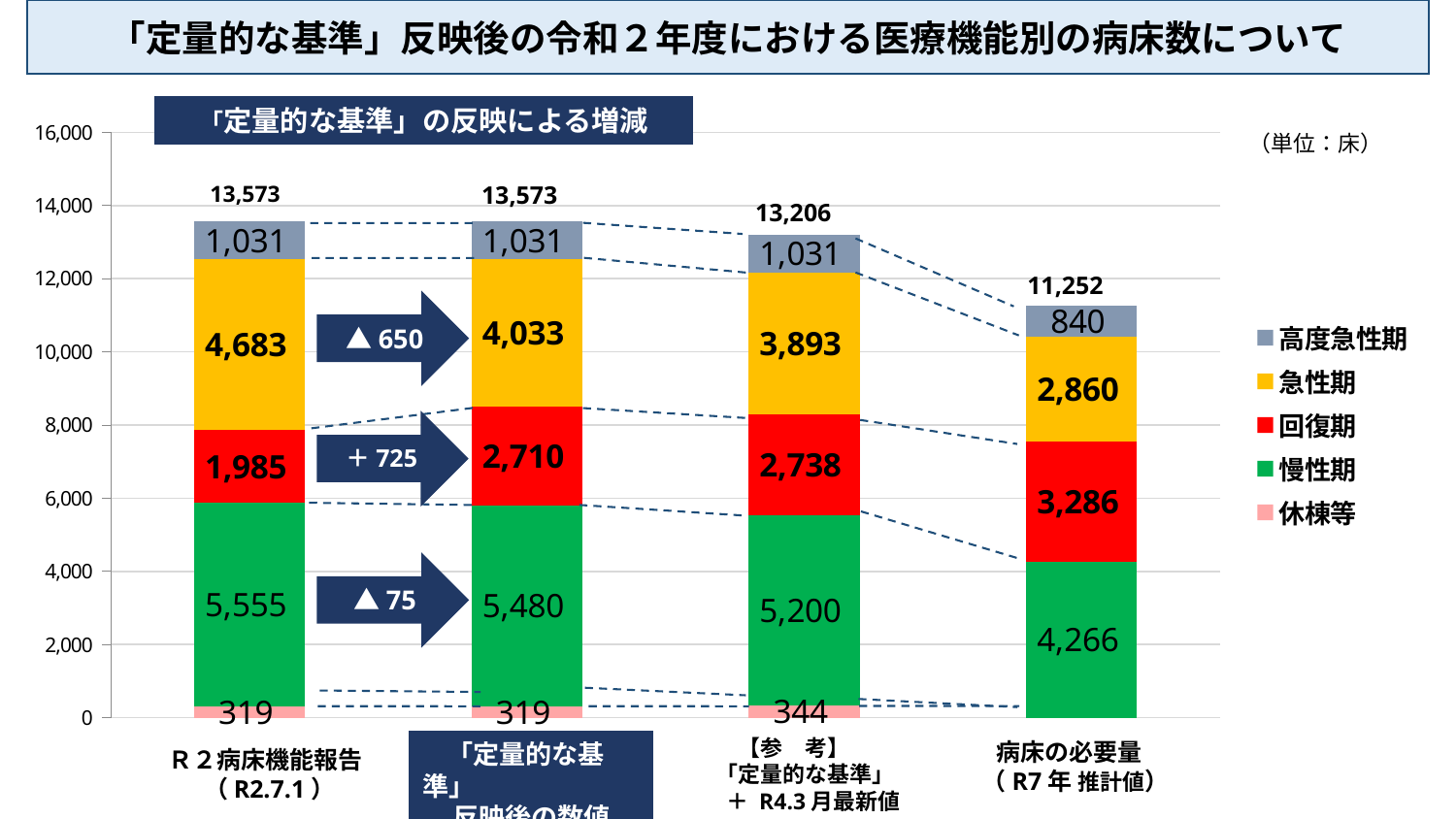
What is the 急性期 value for the R２病床機能報告（R2.7.1） bar? 4,683 What is the total of the 【参考】「定量的な基準」＋R4.3月最新値 bar? 13,206 What is the 回復期 value for the 「定量的な基準」反映後の数値 bar? 2,710 What type of chart is shown on the slide? Stacked bar chart Which bar has the lowest total? 病床の必要量（R7年推計値） What is the 慢性期 value for the 病床の必要量（R7年推計値） bar? 4,266 How many bars (categories) are plotted on the chart? 4 Is the total of the 病床の必要量（R7年推計値） bar greater or less than 12,000? less Which is larger: 回復期 in the 病床の必要量（R7年推計値） bar or 回復期 in the 【参考】「定量的な基準」＋R4.3月最新値 bar? 病床の必要量（R7年推計値） What is the difference in 急性期 between the R２病床機能報告（R2.7.1） bar and the 「定量的な基準」反映後の数値 bar? 650 What unit is indicated for the values on the chart? 床 How many series does the legend list? 5